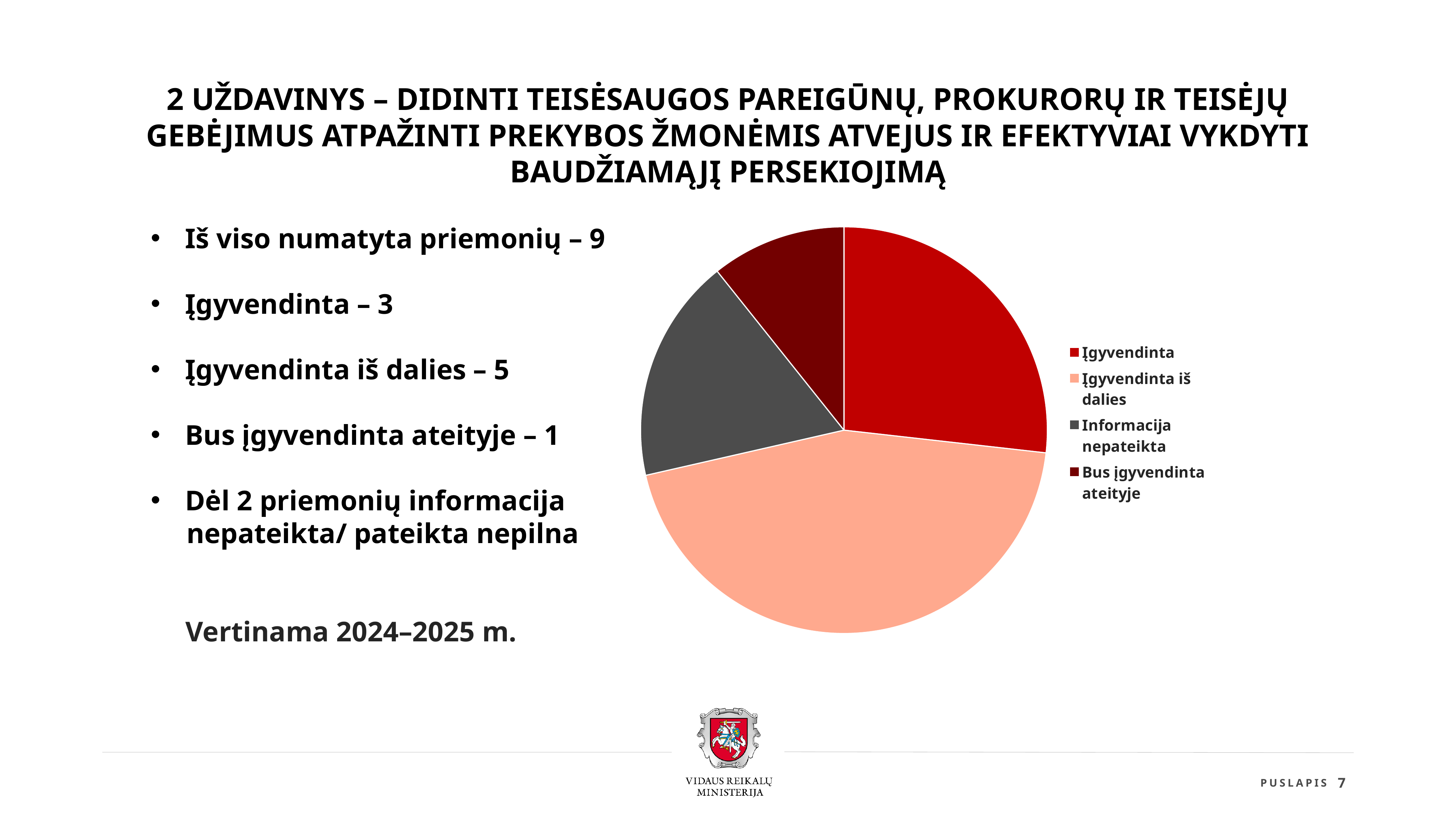
What is the difference between the number of measures Įgyvendinta iš dalies and Įgyvendinta? 2 How many entries does the legend of the pie chart list? 4 Which category has the largest slice in the pie chart? Įgyvendinta iš dalies Which slice is larger in the pie chart: Įgyvendinta iš dalies or Įgyvendinta? Įgyvendinta iš dalies According to the slide, how many measures are Įgyvendinta? 3 Which slice is larger in the pie chart: Įgyvendinta or Informacija nepateikta? Įgyvendinta How many slices does the pie chart have? 4 According to the slide, how many measures are Bus įgyvendinta ateityje? 1 Which category has the smallest slice in the pie chart? Bus įgyvendinta ateityje What kind of chart is shown on the slide? pie chart Which legend entry of the pie chart is shown in dark grey? Informacija nepateikta According to the slide, how many measures are Įgyvendinta iš dalies? 5